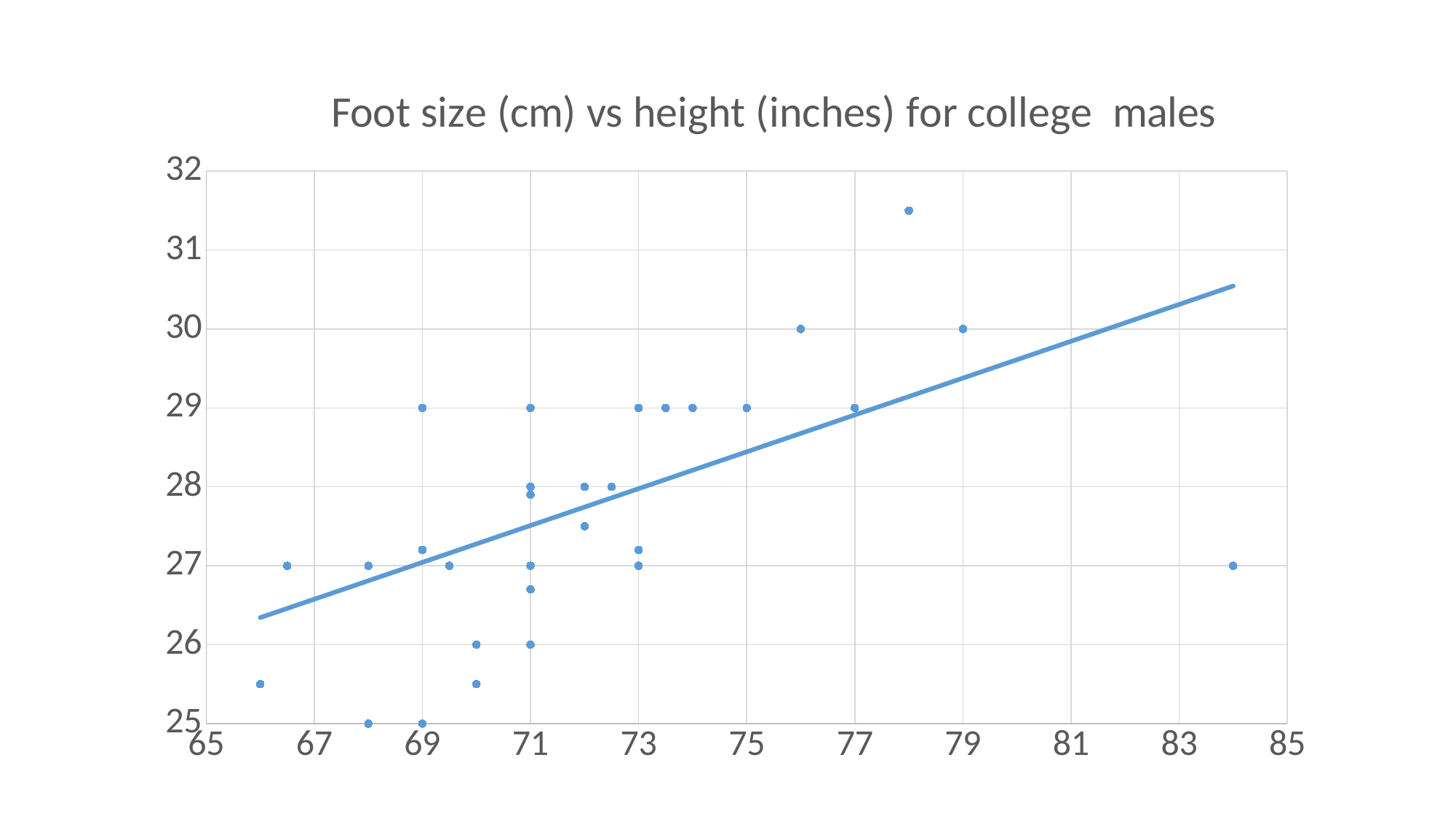
Is the foot size of the highest plotted point greater or less than 31? greater What is the title of the chart? Foot size (cm) vs height (inches) for college males What foot size is plotted for the point at a height of 75 inches? 29 What is the smallest foot size value plotted on the chart? 25 What foot size is plotted for the point at a height of 77 inches? 29 Does the fitted trend line rise or fall as height increases? Rises What range does the horizontal (height) axis cover? 65 to 85 Is the foot size of the rightmost plotted point (at about 84 inches) greater or less than 28? less Which has the larger foot size: the point at height 79 inches or the point at height 75 inches? 79 inches What foot size is plotted for the point at a height of 79 inches? 30 How many plotted points have a foot size of exactly 30 cm? 2 What kind of chart is shown on the slide? Scatter chart